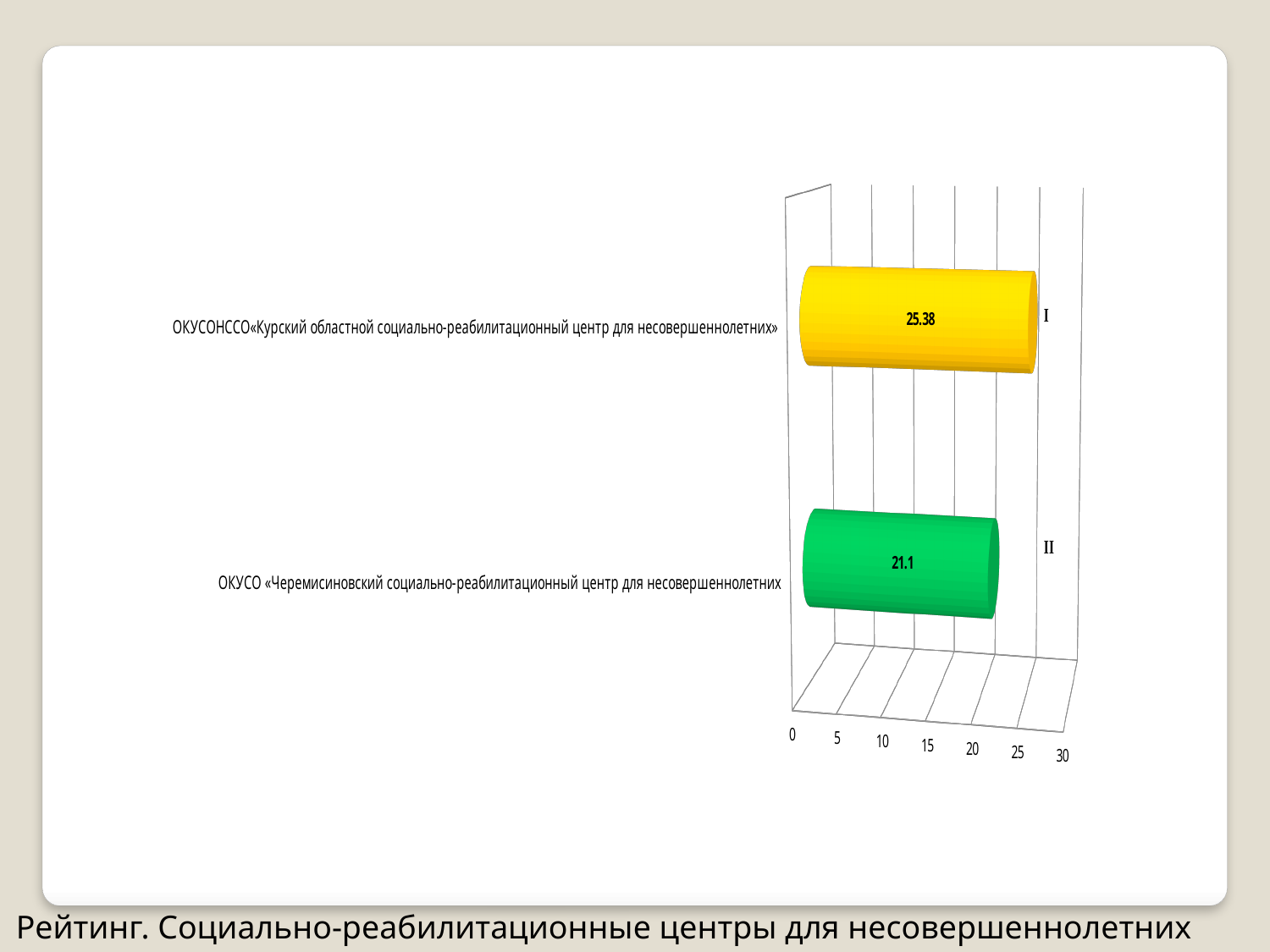
Which is larger: the value for the Курский centre or the Черемисиновский centre? Курский centre Is the value for the Черемисиновский centre greater or less than 25? less What kind of chart is shown on the slide? Bar chart Is the value for the Курский centre greater or less than 20? greater Which centre has the highest value? ОКУСОНССО «Курский областной социально-реабилитационный центр для несовершеннолетних» What is the value for ОКУСО «Черемисиновский социально-реабилитационный центр для несовершеннолетних»? 21.1 What rank label is shown next to the bar for the Курский centre? I Which centre has the lowest value? ОКУСО «Черемисиновский социально-реабилитационный центр для несовершеннолетних» What colour is the bar for the Черемисиновский centre? Green What is the value for ОКУСОНССО «Курский областной социально-реабилитационный центр для несовершеннолетних»? 25.38 What is the difference between the values for the Курский and Черемисиновский centres? 4.28 How many categories are shown in the chart? 2